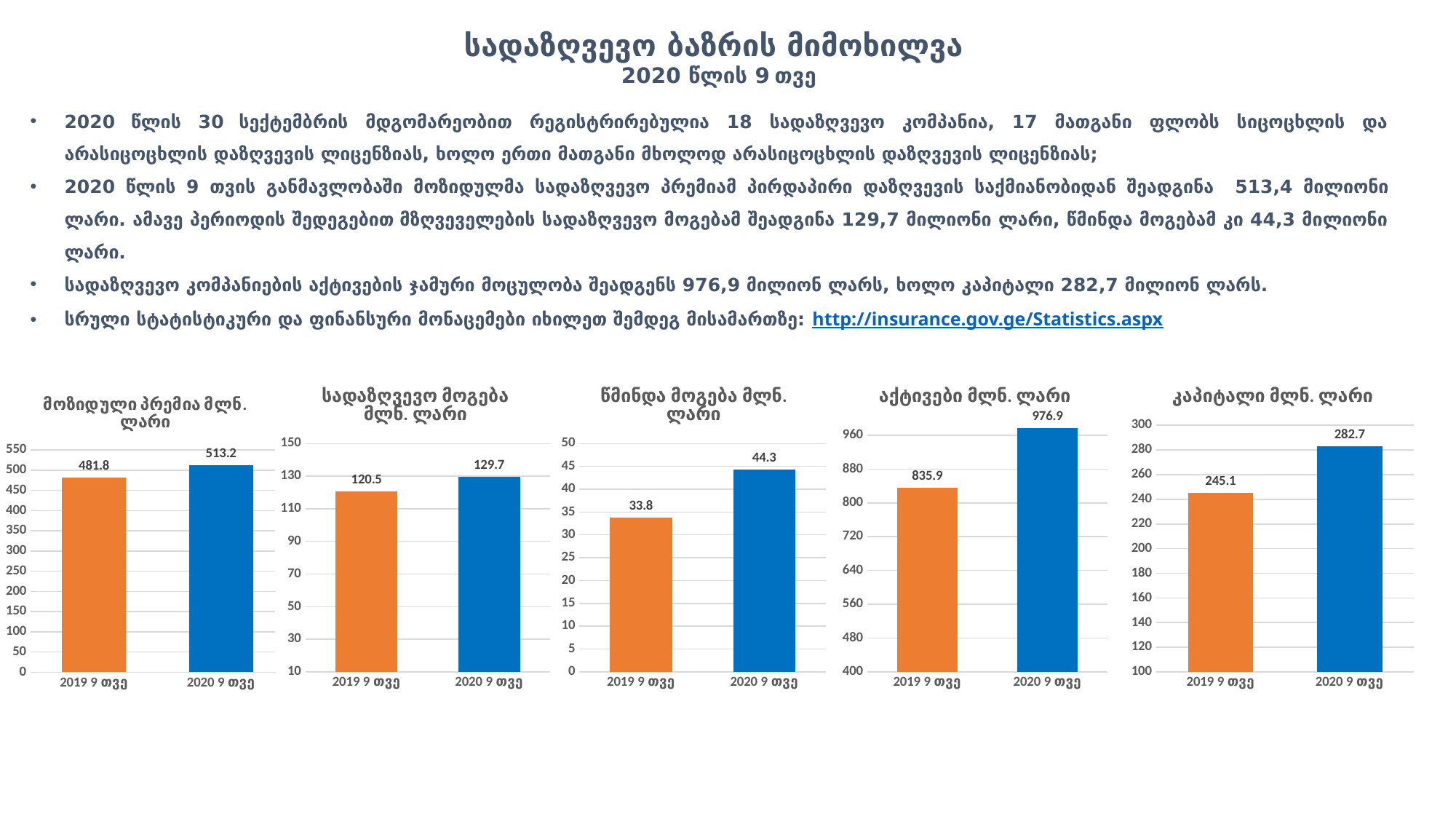
In the second chart from the left (სადაზღვევო მოგება მლნ. ლარი), what is the difference between the 2020 9 თვე and 2019 9 თვე values? 9.2 In the leftmost chart (მოზიდული პრემია მლნ. ლარი), what is the value for 2020 9 თვე? 513.2 In the rightmost chart (კაპიტალი მლნ. ლარი), is the value for 2020 9 თვე larger or smaller than the value for 2019 9 თვე? larger In the fourth chart from the left (აქტივები მლნ. ლარი), what is the value for 2020 9 თვე? 976.9 How many bar charts are shown on the slide? 5 In the rightmost chart (კაპიტალი მლნ. ლარი), what is the value for 2019 9 თვე? 245.1 In the middle chart (წმინდა მოგება მლნ. ლარი), which period has the higher value? 2020 9 თვე In the second chart from the left (სადაზღვევო მოგება მლნ. ლარი), what is the value for 2020 9 თვე? 129.7 In the leftmost chart (მოზიდული პრემია მლნ. ლარი), what is the value for 2019 9 თვე? 481.8 In the middle chart (წმინდა მოგება მლნ. ლარი), what is the value for 2019 9 თვე? 33.8 In the fourth chart from the left (აქტივები მლნ. ლარი), what is the difference between the 2020 9 თვე and 2019 9 თვე values? 141.0 What type of chart is the leftmost chart (მოზიდული პრემია მლნ. ლარი)? bar chart